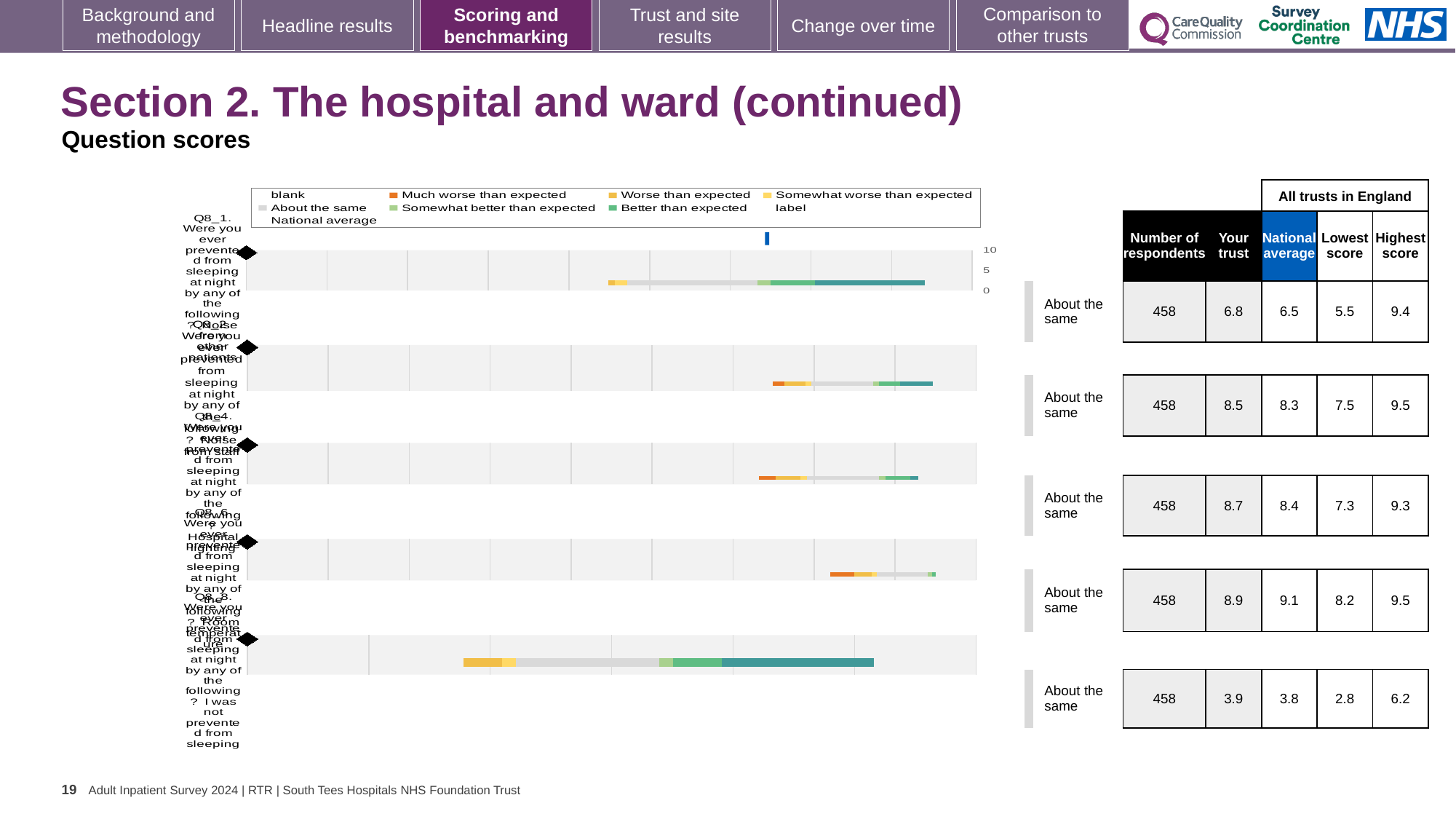
In the chart legend, which colour represents 'Better than expected'? teal For the first bar chart (Q8_1), which is larger: the 'Your trust' score or the national average? Your trust In the table beside the first bar chart (Q8_1), what is the 'Your trust' score? 6.8 What benchmark rating is shown beside the first bar chart (Q8_1)? About the same Which bar chart row has the highest 'Your trust' score in the table? the fourth row (8.9) How many of the bar charts are rated 'About the same'? 5 What kind of chart is used to show the question scores on this slide? bar chart In the table beside the first bar chart (Q8_1), what is the number of respondents? 458 In the table beside the bottom bar chart, what is the national average score? 3.8 In the chart legend, which colour represents 'Much worse than expected'? orange How many horizontal bar charts (question rows) are shown on the slide? 5 Which bar chart row has the lowest 'Your trust' score in the table? the bottom row (3.9)